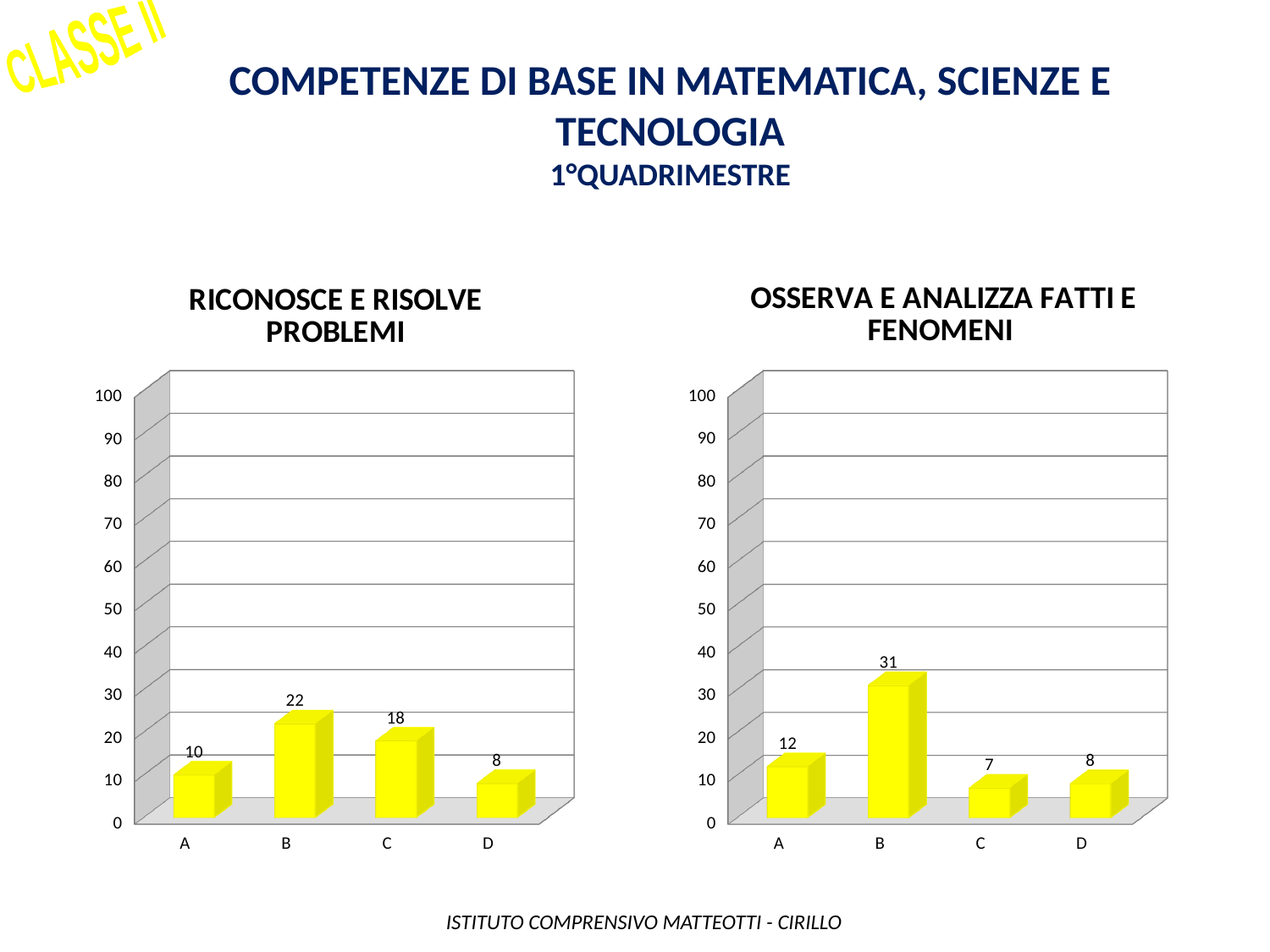
In the 'RICONOSCE E RISOLVE PROBLEMI' chart, which category has the lowest value? D What is the title of the chart on the left side of the slide? RICONOSCE E RISOLVE PROBLEMI How many categories are shown on the x axis of the 'RICONOSCE E RISOLVE PROBLEMI' chart? 4 In the 'OSSERVA E ANALIZZA FATTI E FENOMENI' chart, what is the value for category C? 7 In the 'OSSERVA E ANALIZZA FATTI E FENOMENI' chart, which is larger, the value for A or the value for D? A In the 'RICONOSCE E RISOLVE PROBLEMI' chart, what is the difference between the values for B and C? 4 In the 'RICONOSCE E RISOLVE PROBLEMI' chart, which category has the highest value? B In the 'OSSERVA E ANALIZZA FATTI E FENOMENI' chart, is the value for B greater or less than 20? greater In the 'OSSERVA E ANALIZZA FATTI E FENOMENI' chart, what is the difference between the values for B and A? 19 What kind of chart is the 'OSSERVA E ANALIZZA FATTI E FENOMENI' chart? bar chart In the 'OSSERVA E ANALIZZA FATTI E FENOMENI' chart, which category has the lowest value? C In the 'RICONOSCE E RISOLVE PROBLEMI' chart, what is the value for category B? 22